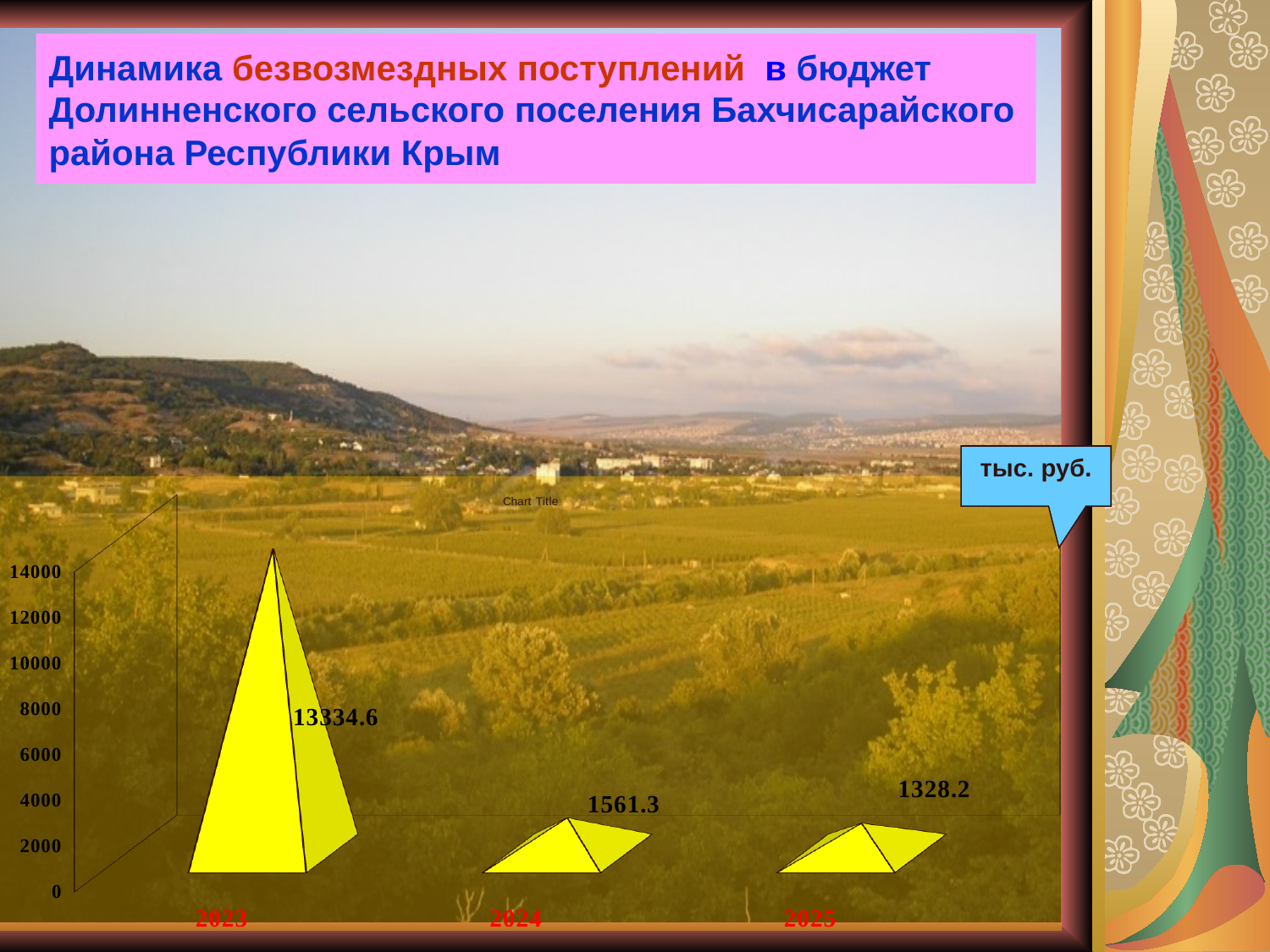
Which year has the lowest value? 2025 Is the value for 2023 greater or less than 12000? greater What is the difference between the values for 2023 and 2024? 11773.3 What is the value for 2024? 1561.3 What is the value for 2025? 1328.2 What is the value for 2023? 13334.6 What is the difference between the values for 2024 and 2025? 233.1 Do the values rise or fall from 2023 to 2025? fall Which is larger, the value for 2024 or the value for 2025? 2024 Which year has the highest value? 2023 What unit is shown in the callout next to the chart? тыс. руб. How many years are shown on the x axis? 3